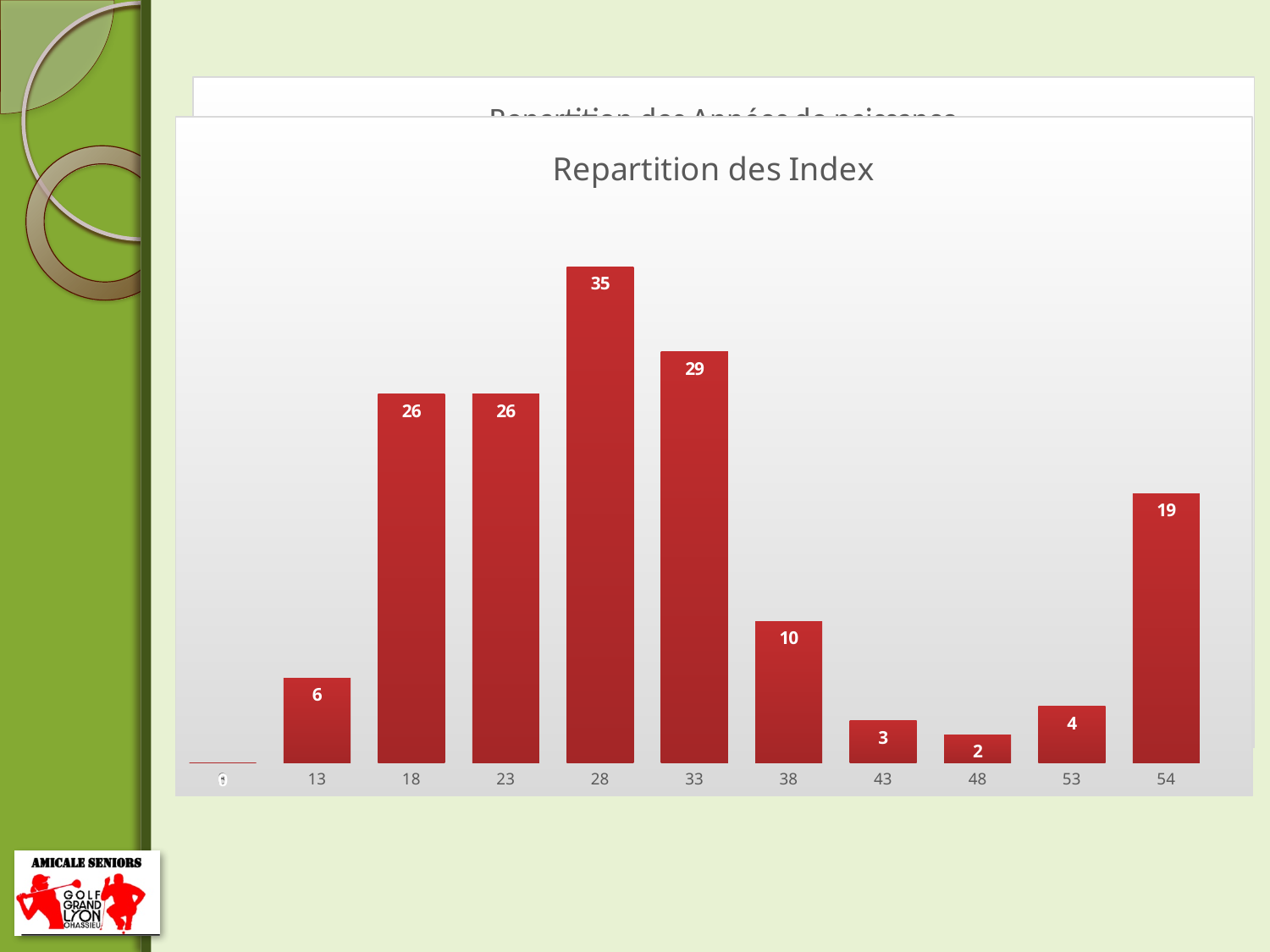
What is the title of the chart on the slide? Repartition des Index What kind of chart is shown under the title "Repartition des Index"? bar chart In the "Repartition des Index" chart, what is the difference between the values for categories 54 and 38? 9 In the "Repartition des Index" chart, what is the difference between the values for categories 28 and 33? 6 In the "Repartition des Index" chart, what is the value for category 54? 19 In the "Repartition des Index" chart, do the values rise or fall from category 28 to category 48? fall In the "Repartition des Index" chart, what is the value for category 48? 2 In the "Repartition des Index" chart, how many bars have a value greater than 20? 4 In the "Repartition des Index" chart, what is the value for category 13? 6 In the "Repartition des Index" chart, what is the value for category 28? 35 In the "Repartition des Index" chart, which has the larger value, category 33 or category 54? 33 Which category has the highest value in the "Repartition des Index" chart? 28